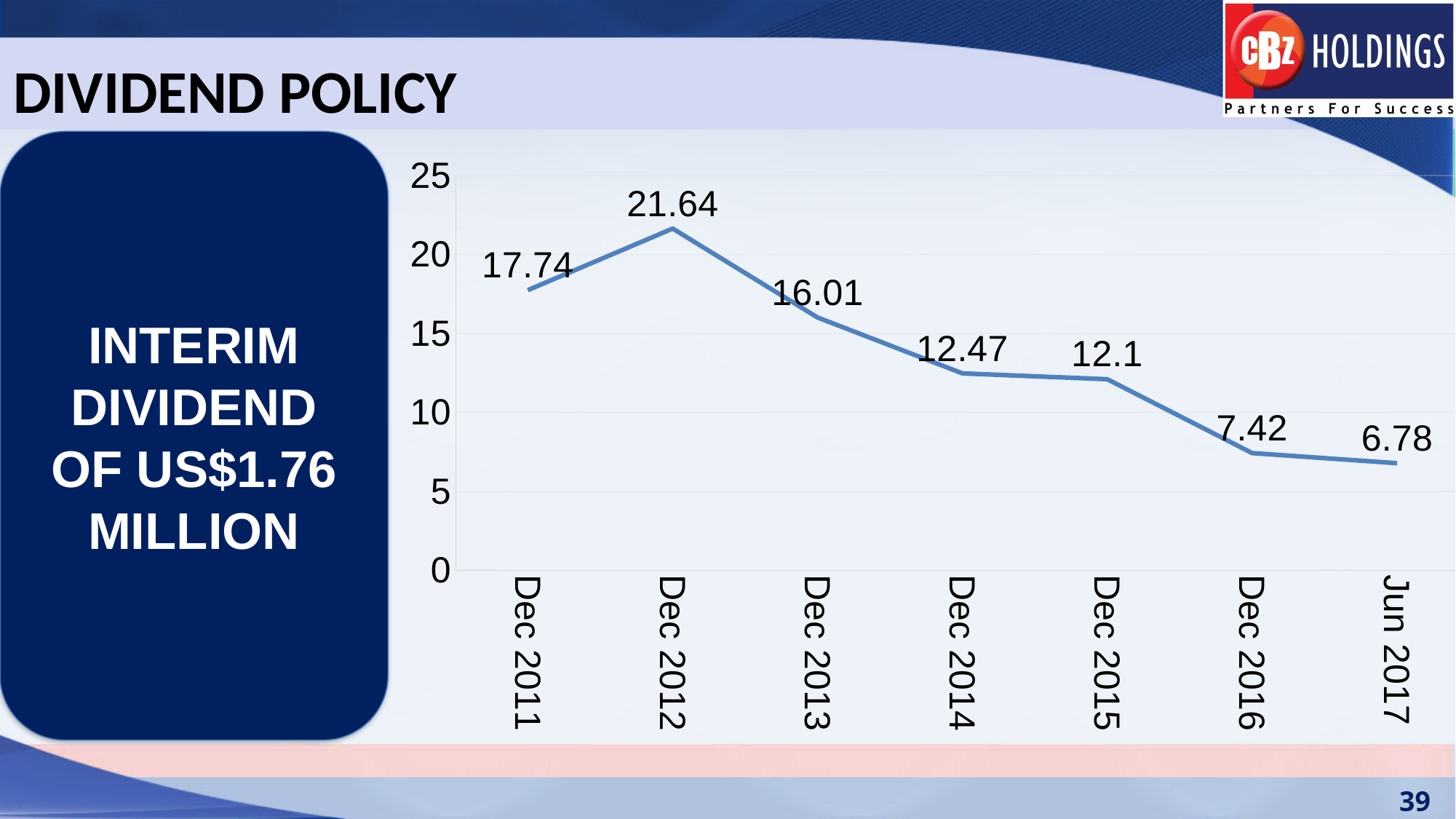
What is the value for Jun 2017? 6.78 Which is larger, the value for Dec 2011 or the value for Dec 2013? Dec 2011 Which period has the highest value? Dec 2012 Which period has the lowest value? Jun 2017 What is the value for Dec 2012? 21.64 What is the value for Dec 2014? 12.47 What kind of chart is shown on the slide? line chart What is the difference between the values for Dec 2016 and Jun 2017? 0.64 Do the values rise or fall from Dec 2012 to Jun 2017? fall Is the value for Dec 2015 greater or less than 15? less How many periods are plotted on the chart? 7 What is the difference between the values for Dec 2012 and Dec 2013? 5.63